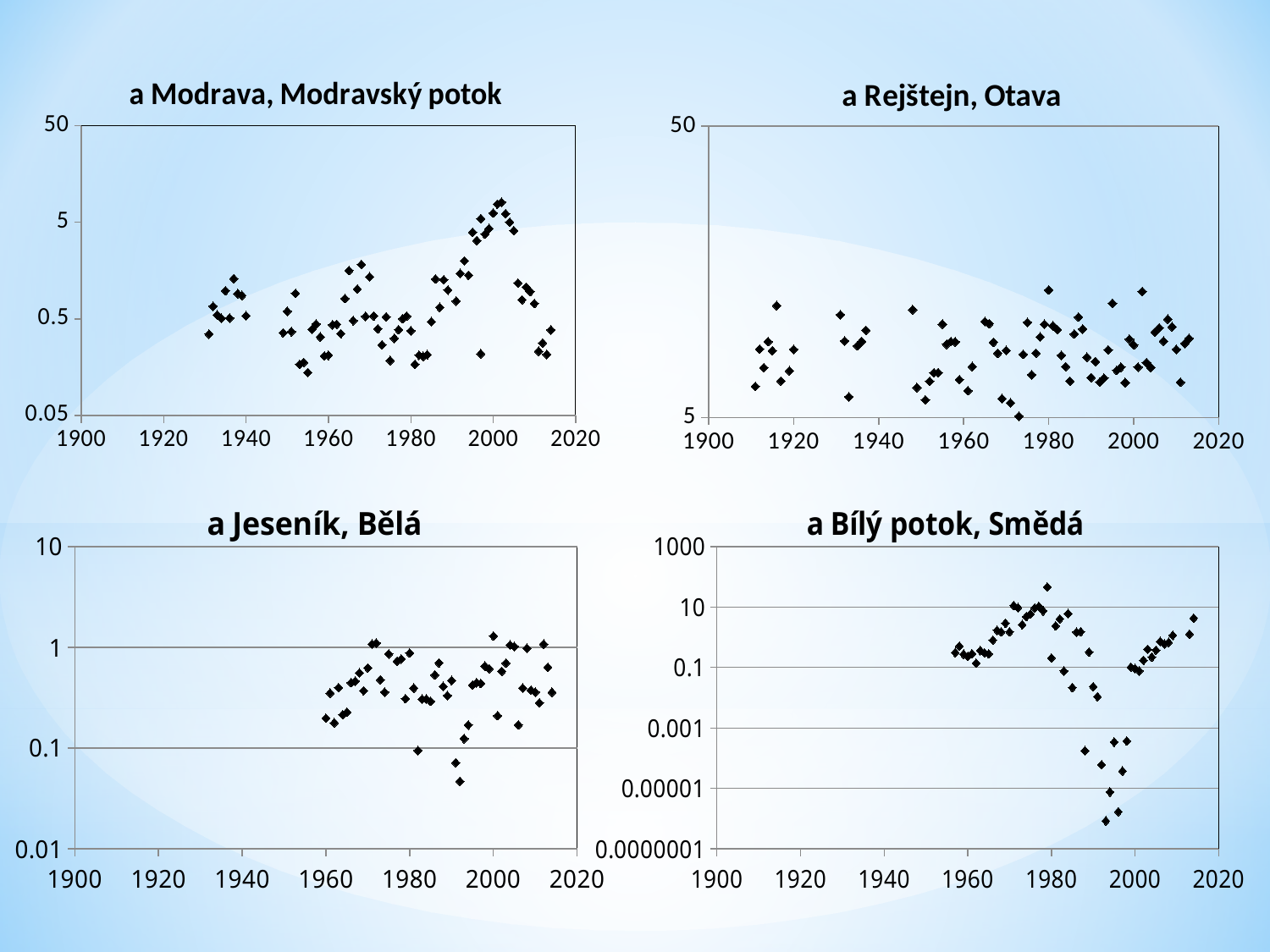
How many charts are shown on the slide? 4 In 'a Jeseník, Bělá', is the lowest plotted value greater or less than 0.1? less In 'a Jeseník, Bělá', is the highest plotted value greater or less than 1? greater In 'a Bílý potok, Smědá', is the lowest plotted value greater or less than 0.00001? less What is the title of the bottom-left chart? a Jeseník, Bělá What kind of chart is 'a Modrava, Modravský potok'? scatter chart In 'a Modrava, Modravský potok', which is larger: the value around 2001 or the value around 1955? the value around 2001 In 'a Bílý potok, Smědá', do the values rise or fall between 1980 and 1995? fall In 'a Modrava, Modravský potok', do the values rise or fall between 1990 and 2001? rise